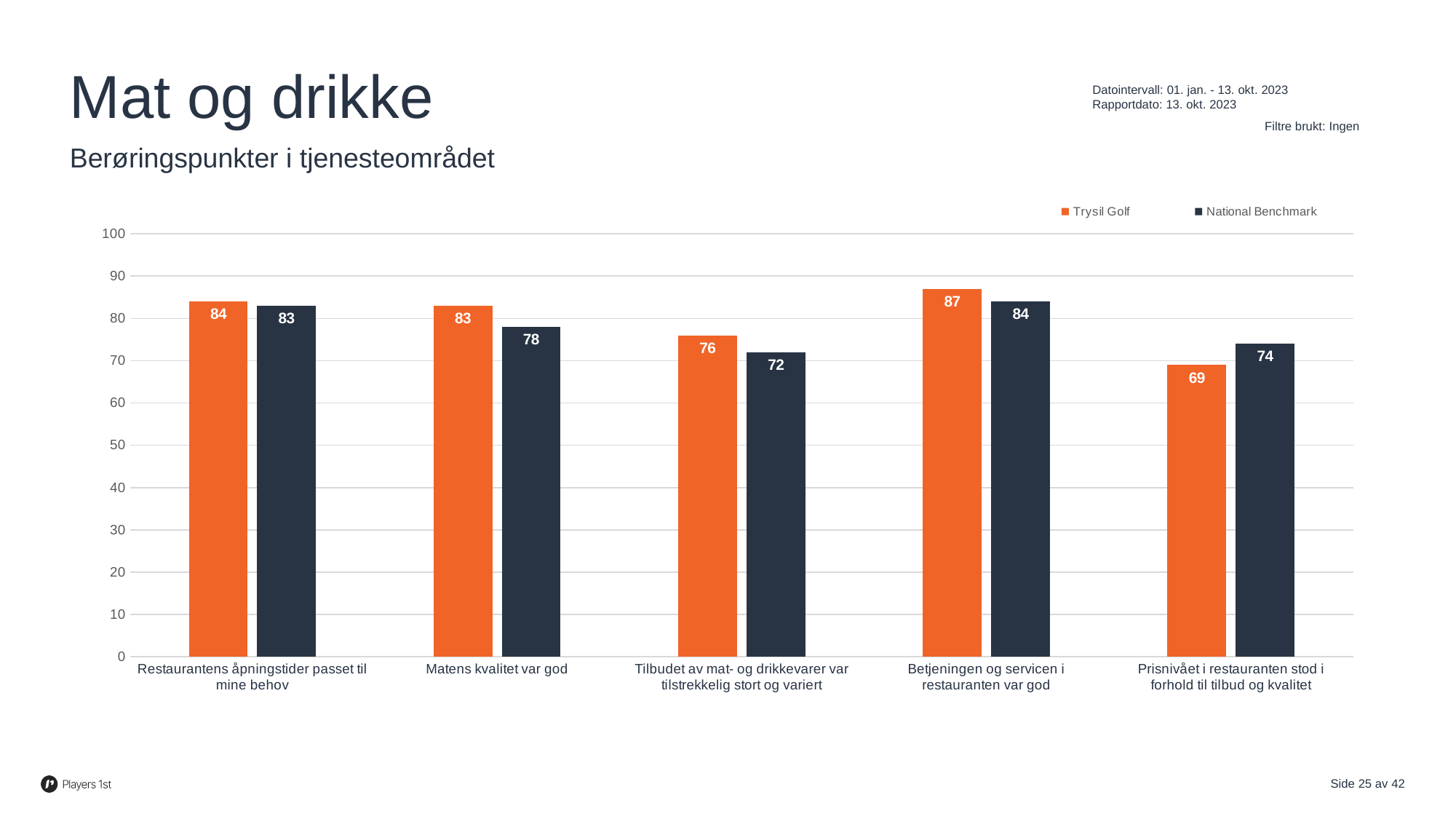
Which category has the lowest National Benchmark value? Tilbudet av mat- og drikkevarer var tilstrekkelig stort og variert Which category has the highest Trysil Golf value? Betjeningen og servicen i restauranten var god How many categories are shown on the x axis? 5 What is the difference between the Trysil Golf and National Benchmark values for "Matens kvalitet var god"? 5 Which series is shown in orange? Trysil Golf What is the Trysil Golf value for "Prisnivået i restauranten stod i forhold til tilbud og kvalitet"? 69 What is the National Benchmark value for "Tilbudet av mat- og drikkevarer var tilstrekkelig stort og variert"? 72 For "Prisnivået i restauranten stod i forhold til tilbud og kvalitet", which is larger: Trysil Golf or National Benchmark? National Benchmark How many series does the legend list? 2 What is the Trysil Golf value for "Matens kvalitet var god"? 83 What kind of chart is shown on the slide? Bar chart Is the National Benchmark value for "Betjeningen og servicen i restauranten var god" greater or less than 80? greater